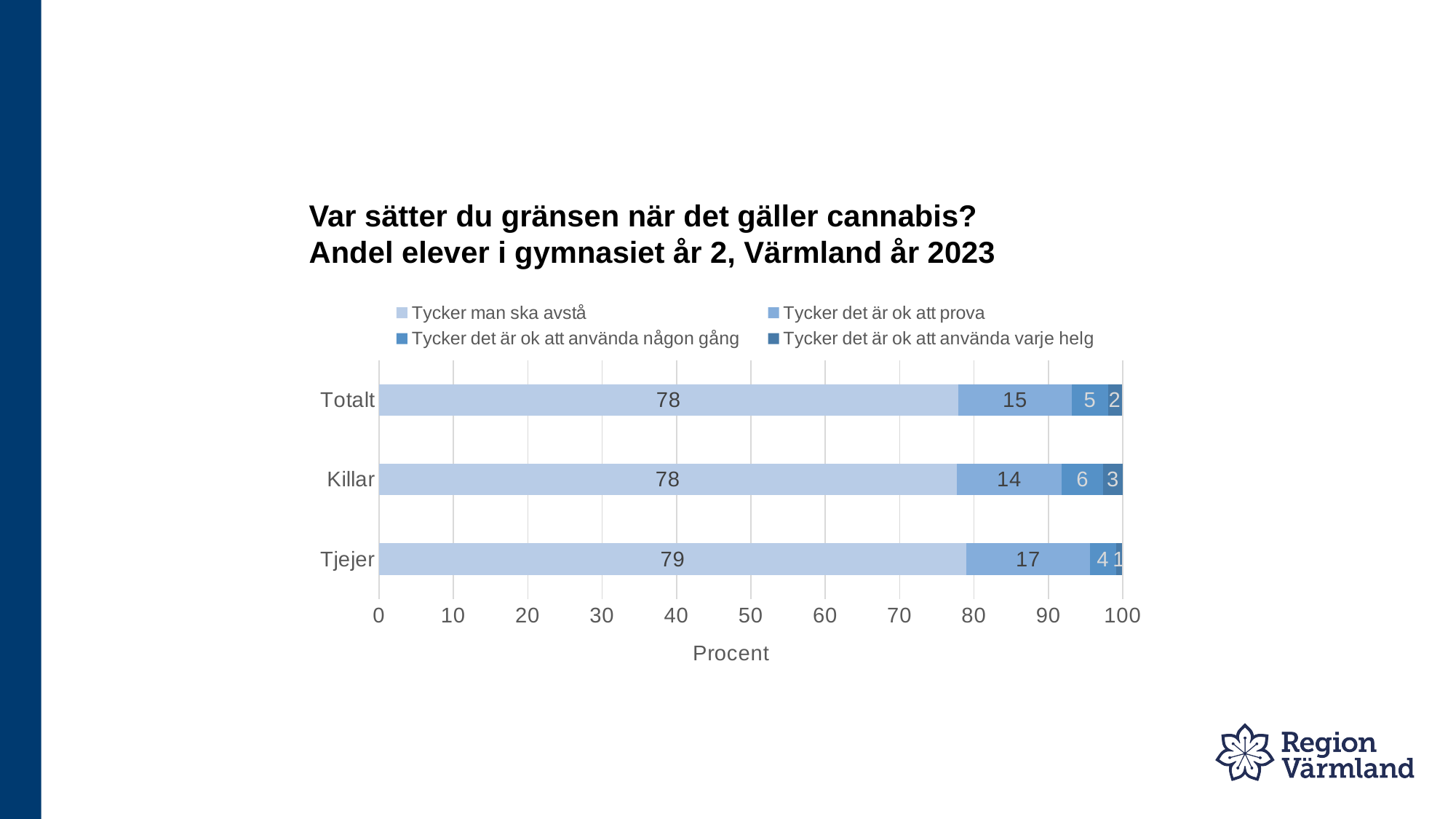
What kind of chart is this? Bar chart What is the value for "Tycker man ska avstå" for Tjejer? 79 What is the value for "Tycker det är ok att använda varje helg" for Killar? 3 Which category has the highest value for "Tycker det är ok att prova"? Tjejer Which category has the lowest value for "Tycker det är ok att använda varje helg"? Tjejer What is the total of the stacked bar for Totalt? 100 How many series does the legend list? 4 How many categories are shown on the y axis? 3 What is the value for "Tycker det är ok att prova" for Killar? 14 What is the value for "Tycker det är ok att använda någon gång" for Totalt? 5 Which is larger: the "Tycker det är ok att använda någon gång" value for Killar or for Tjejer? Killar What is the difference between the "Tycker det är ok att prova" values for Tjejer and Killar? 3